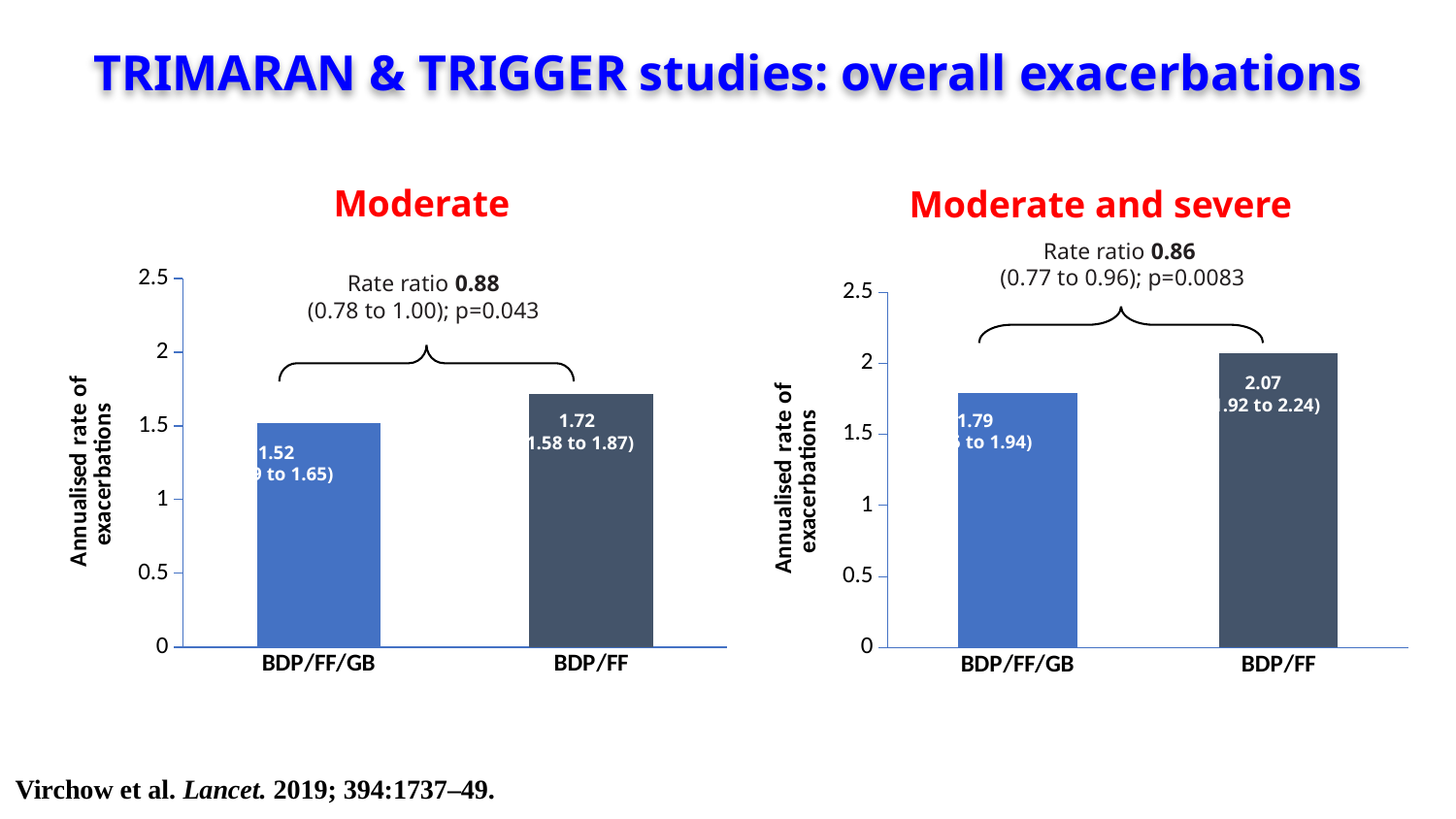
In the Moderate and severe chart, what is the annualised rate of exacerbations for BDP/FF/GB? 1.79 In the Moderate and severe chart, is the value for BDP/FF greater or less than 2? greater How many bars are shown in the Moderate chart? 2 In the Moderate and severe chart, what is the annualised rate of exacerbations for BDP/FF? 2.07 What rate ratio is shown above the Moderate chart? 0.88 In the Moderate chart, what is the difference between the BDP/FF and BDP/FF/GB rates? 0.20 In the Moderate chart, what is the annualised rate of exacerbations for BDP/FF/GB? 1.52 What type of chart is used for the Moderate and severe data? Bar chart In the Moderate and severe chart, what is the difference between the BDP/FF and BDP/FF/GB rates? 0.28 In the Moderate and severe chart, which treatment has the lower annualised rate of exacerbations? BDP/FF/GB In the Moderate chart, which treatment has the higher annualised rate of exacerbations? BDP/FF In the Moderate chart, what is the annualised rate of exacerbations for BDP/FF? 1.72